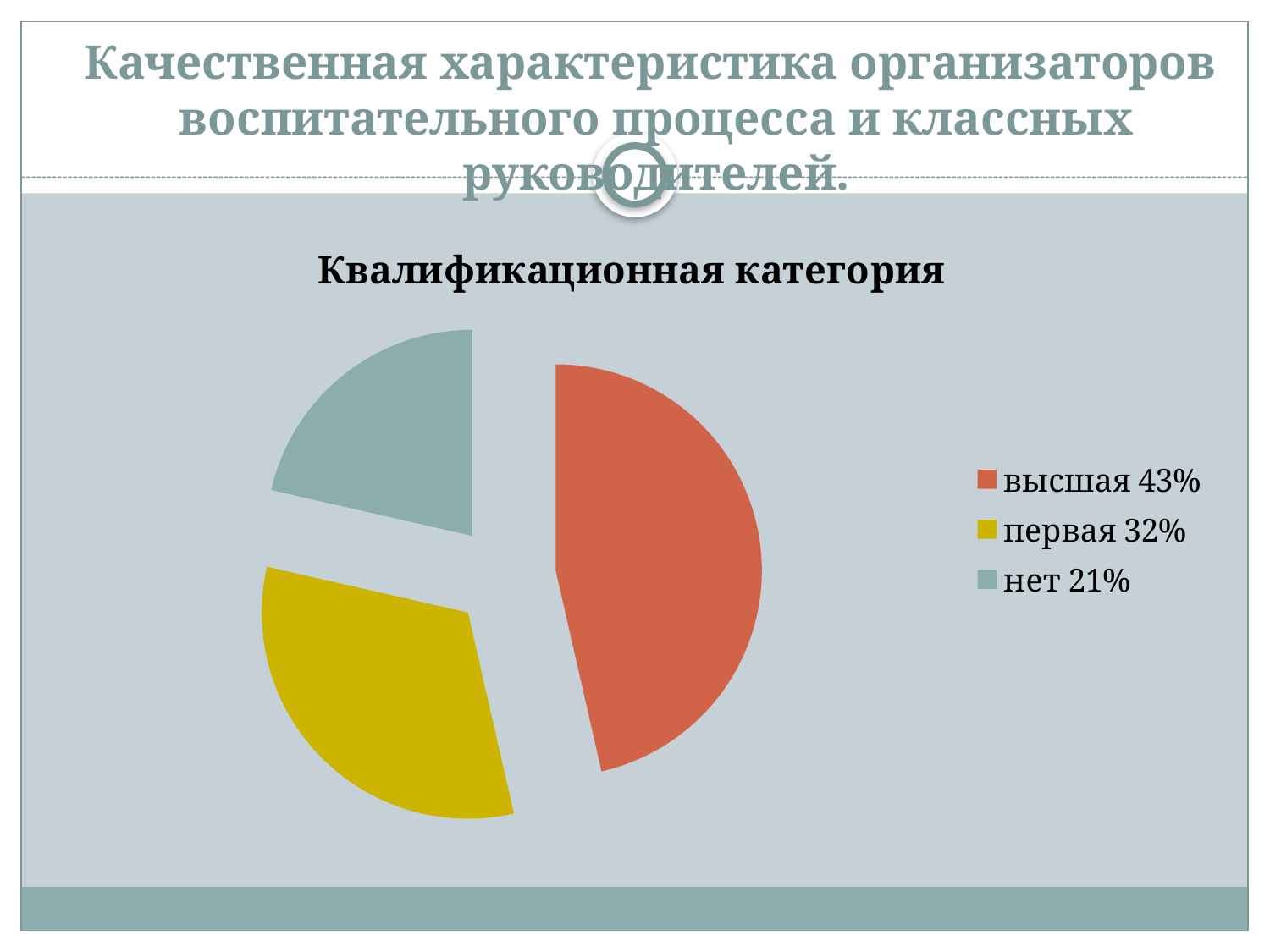
What is the difference in percentage points between "высшая" and "первая"? 11 What is the difference in percentage points between "первая" and "нет"? 11 Which category has the largest share of the pie? высшая What percentage is shown for the category "первая"? 32% How many slices does the pie chart have? 3 What colour is the slice for "высшая"? red (orange-red) What kind of chart is shown on the slide? pie chart Which is larger, the share for "первая" or the share for "нет"? первая What percentage is shown for the category "высшая"? 43% What percentage is shown for the category "нет"? 21% Which category has the smallest share of the pie? нет What is the title of the chart? Квалификационная категория